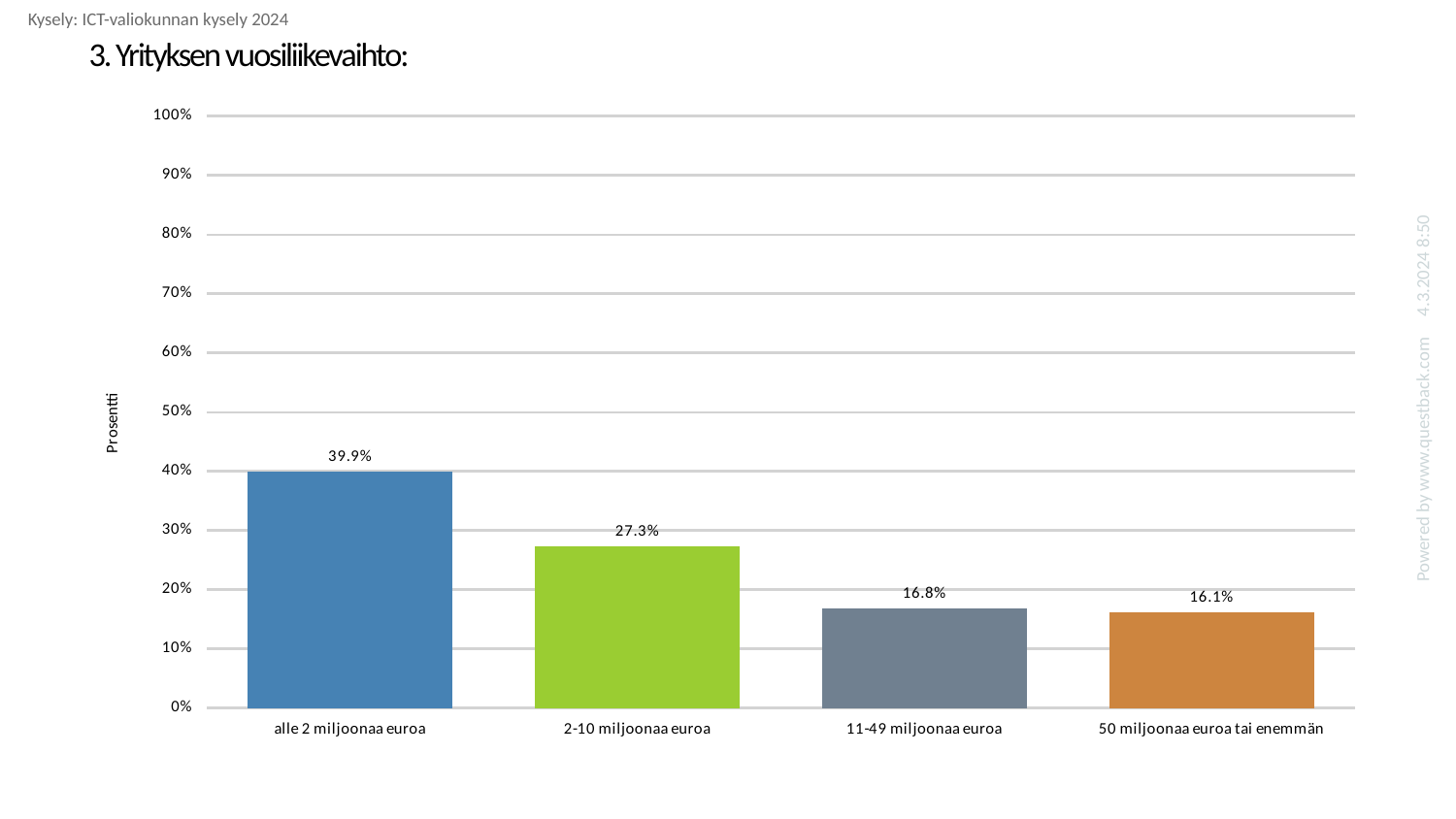
What is the value for 'alle 2 miljoonaa euroa'? 39.9% What is the title of the chart? 3. Yrityksen vuosiliikevaihto: Which category has the highest value? alle 2 miljoonaa euroa Which category has the lowest value? 50 miljoonaa euroa tai enemmän What is the value for '2-10 miljoonaa euroa'? 27.3% What is the value for '11-49 miljoonaa euroa'? 16.8% What is the value for '50 miljoonaa euroa tai enemmän'? 16.1% How many categories are shown on the x axis? 4 What is the difference between the values for 'alle 2 miljoonaa euroa' and '2-10 miljoonaa euroa'? 12.6% Which is larger, the value for '2-10 miljoonaa euroa' or '11-49 miljoonaa euroa'? 2-10 miljoonaa euroa Is the value for 'alle 2 miljoonaa euroa' greater or less than 30%? greater What kind of chart is shown on the slide? bar chart